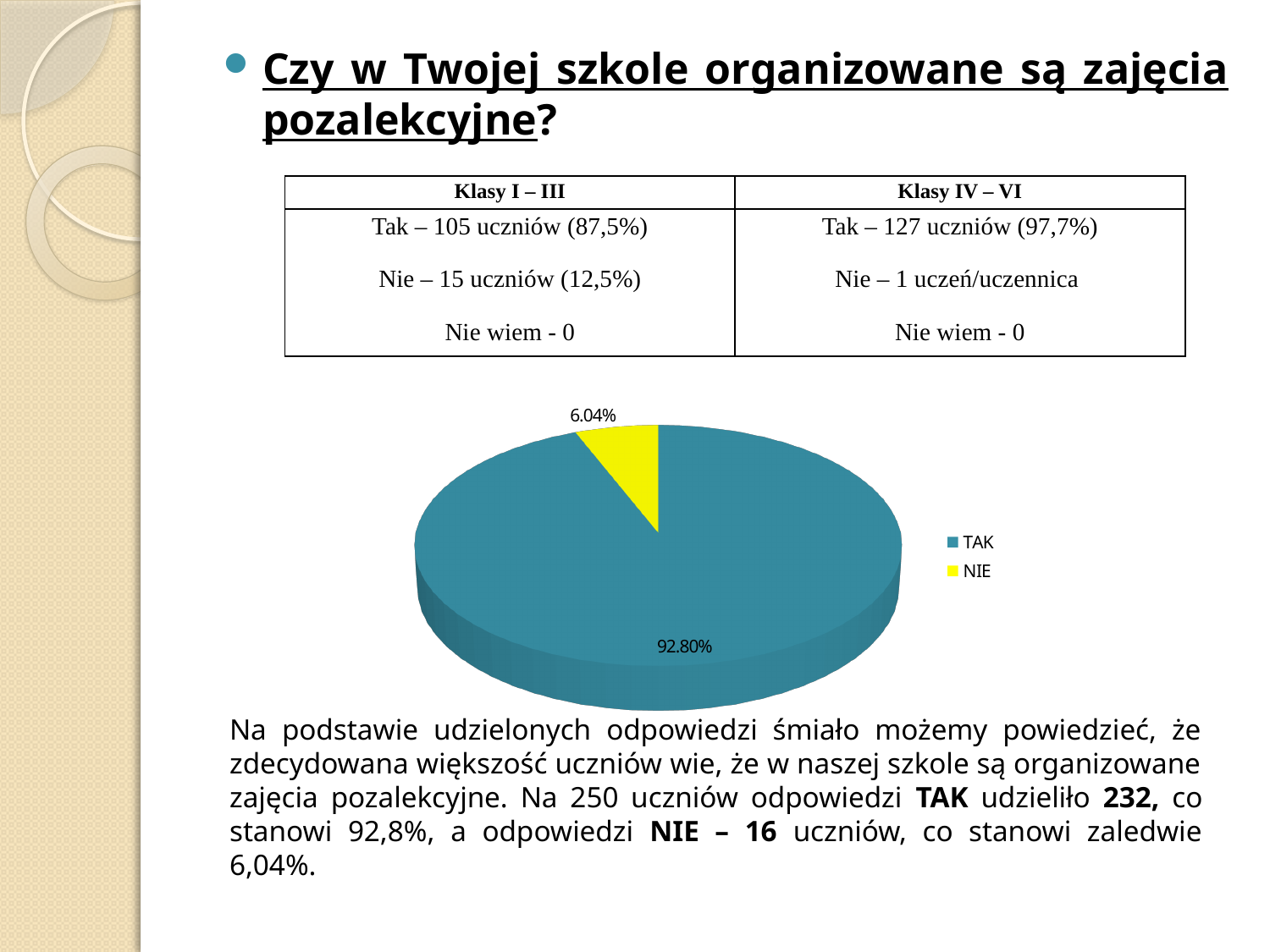
What colour is the NIE slice in the pie chart? Yellow Which category has the largest slice in the pie chart? TAK What kind of chart is shown on the slide? Pie chart What are the two legend entries of the pie chart? TAK and NIE Which category has the smallest slice in the pie chart? NIE What is the difference in percentage points between the TAK and NIE slices of the pie chart? 86.76% What share of the pie does the NIE slice represent? 6.04% Which slice is larger in the pie chart, TAK or NIE? TAK How many slices does the pie chart have? 2 What percentage does the TAK slice of the pie chart show? 92.80% What percentage does the NIE slice of the pie chart show? 6.04% How many entries does the legend of the pie chart list? 2